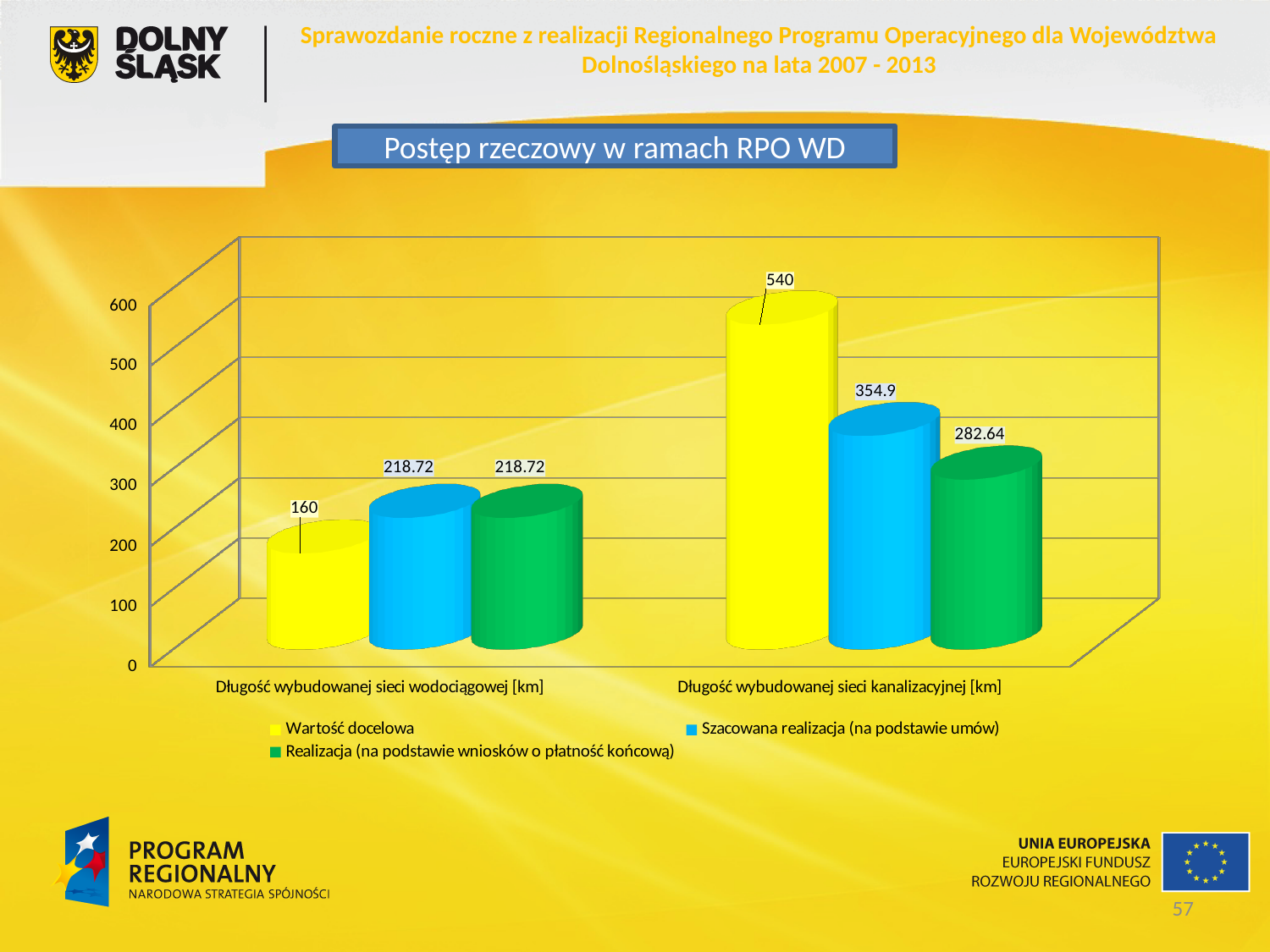
How many categories are shown on the x axis? 2 What is the 'Realizacja (na podstawie wniosków o płatność końcową)' value for 'Długość wybudowanej sieci kanalizacyjnej [km]'? 282.64 What is the 'Wartość docelowa' value for 'Długość wybudowanej sieci wodociągowej [km]'? 160 Which series has the highest value for 'Długość wybudowanej sieci kanalizacyjnej [km]'? Wartość docelowa Which series has the lowest value for 'Długość wybudowanej sieci wodociągowej [km]'? Wartość docelowa What is the difference between 'Szacowana realizacja (na podstawie umów)' and 'Wartość docelowa' for 'Długość wybudowanej sieci wodociągowej [km]'? 58.72 What kind of chart is shown on the slide? Bar chart Which is larger: 'Szacowana realizacja (na podstawie umów)' for the sewage network or 'Realizacja (na podstawie wniosków o płatność końcową)' for the sewage network? Szacowana realizacja (na podstawie umów) What is the 'Szacowana realizacja (na podstawie umów)' value for 'Długość wybudowanej sieci kanalizacyjnej [km]'? 354.9 How many series does the legend list? 3 What is the 'Wartość docelowa' value for 'Długość wybudowanej sieci kanalizacyjnej [km]'? 540 What is the difference between 'Wartość docelowa' and 'Szacowana realizacja (na podstawie umów)' for 'Długość wybudowanej sieci kanalizacyjnej [km]'? 185.1